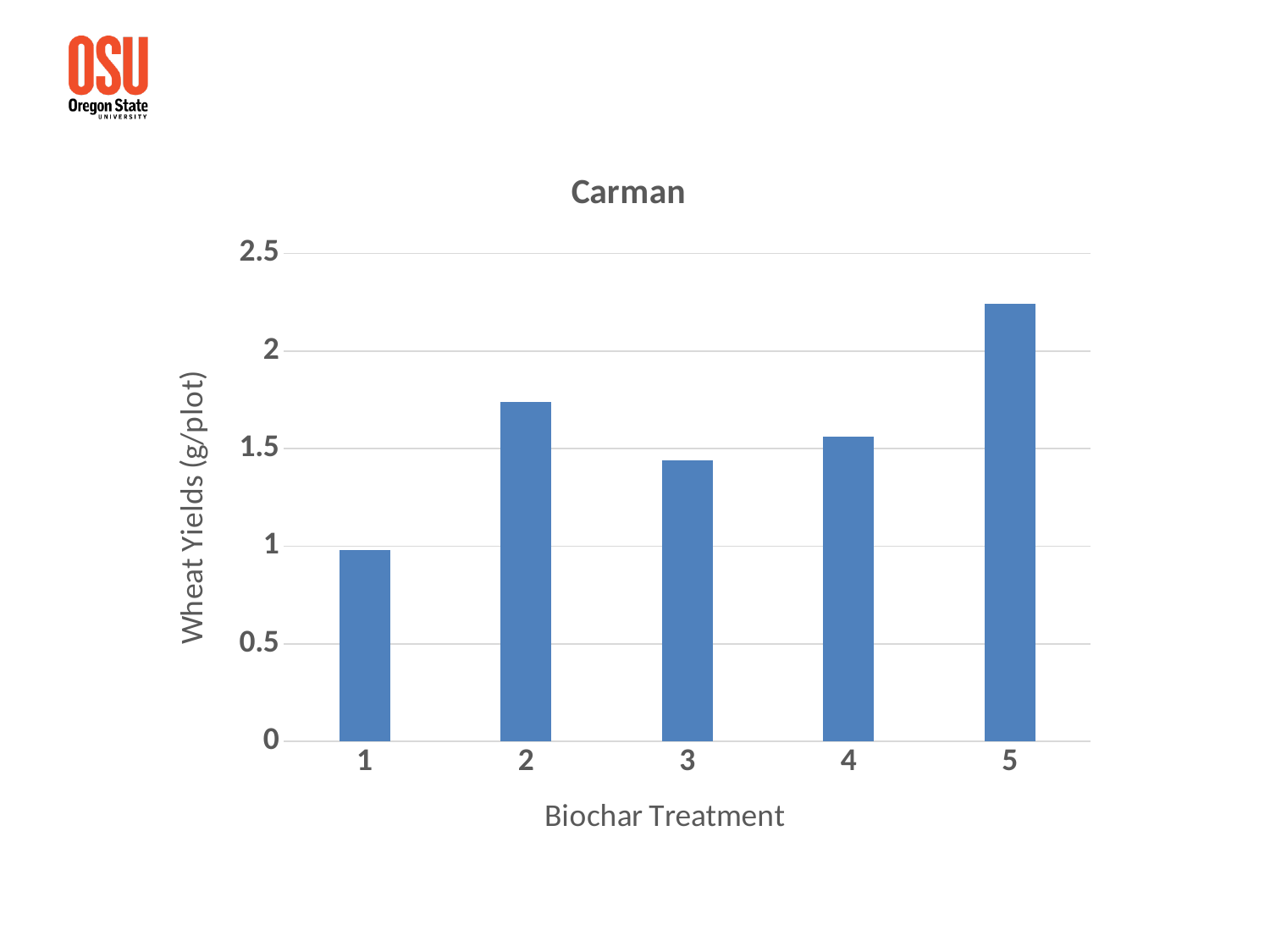
Which has a higher wheat yield, biochar treatment 3 or biochar treatment 1? 3 Is the wheat yield for biochar treatment 2 greater or less than 1.5? greater What is the title of the chart? Carman Which has a higher wheat yield, biochar treatment 2 or biochar treatment 4? 2 Is the wheat yield for biochar treatment 5 greater or less than 2? greater How many biochar treatments are shown on the x axis? 5 What is the label of the y axis? Wheat Yields (g/plot) Is the wheat yield for biochar treatment 3 greater or less than 1.5? less Which biochar treatment has the lowest wheat yield? 1 Which biochar treatment has the highest wheat yield? 5 What type of chart is shown on the slide? bar chart